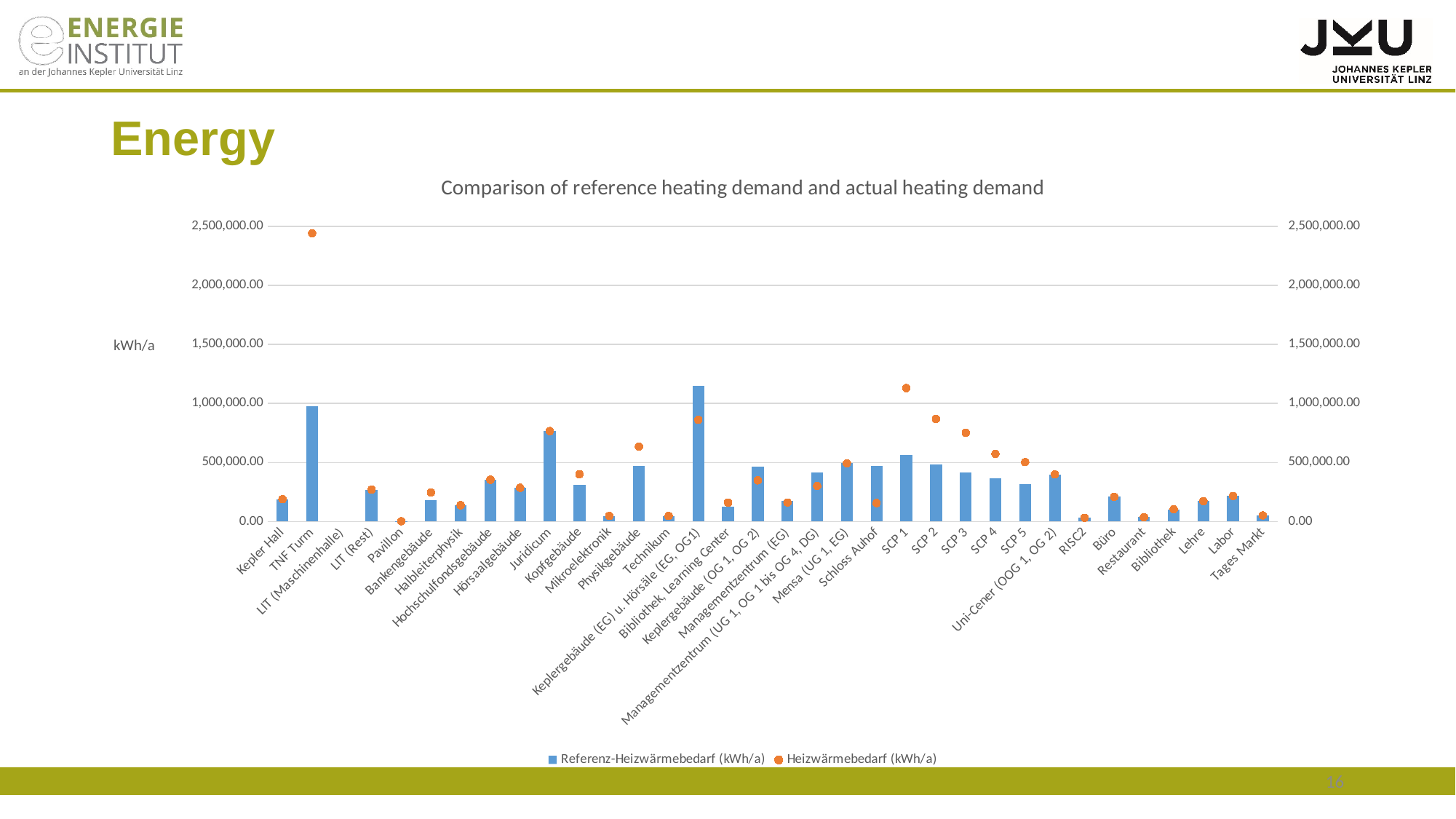
Is the Referenz-Heizwärmebedarf (kWh/a) value for Pavillon greater or less than 500,000.00? less Which building has the highest Heizwärmebedarf (kWh/a) marker? TNF Turm How many buildings are listed along the x axis? 34 What kind of chart is shown on the slide? A bar chart combined with point markers What is the title of the chart? Comparison of reference heating demand and actual heating demand Is the Referenz-Heizwärmebedarf (kWh/a) value for TNF Turm greater or less than 500,000.00? greater Is the Heizwärmebedarf (kWh/a) value for TNF Turm greater or less than 2,000,000.00? greater Which building has the highest Referenz-Heizwärmebedarf (kWh/a) bar? Keplergebäude (EG) u. Hörsäle (EG, OG1) For SCP 1, which is larger: the Referenz-Heizwärmebedarf (kWh/a) bar or the Heizwärmebedarf (kWh/a) marker? Heizwärmebedarf (kWh/a) Which has the larger Referenz-Heizwärmebedarf (kWh/a) bar, TNF Turm or Kepler Hall? TNF Turm How many series does the legend list? 2 What unit is shown on the vertical axis label? kWh/a